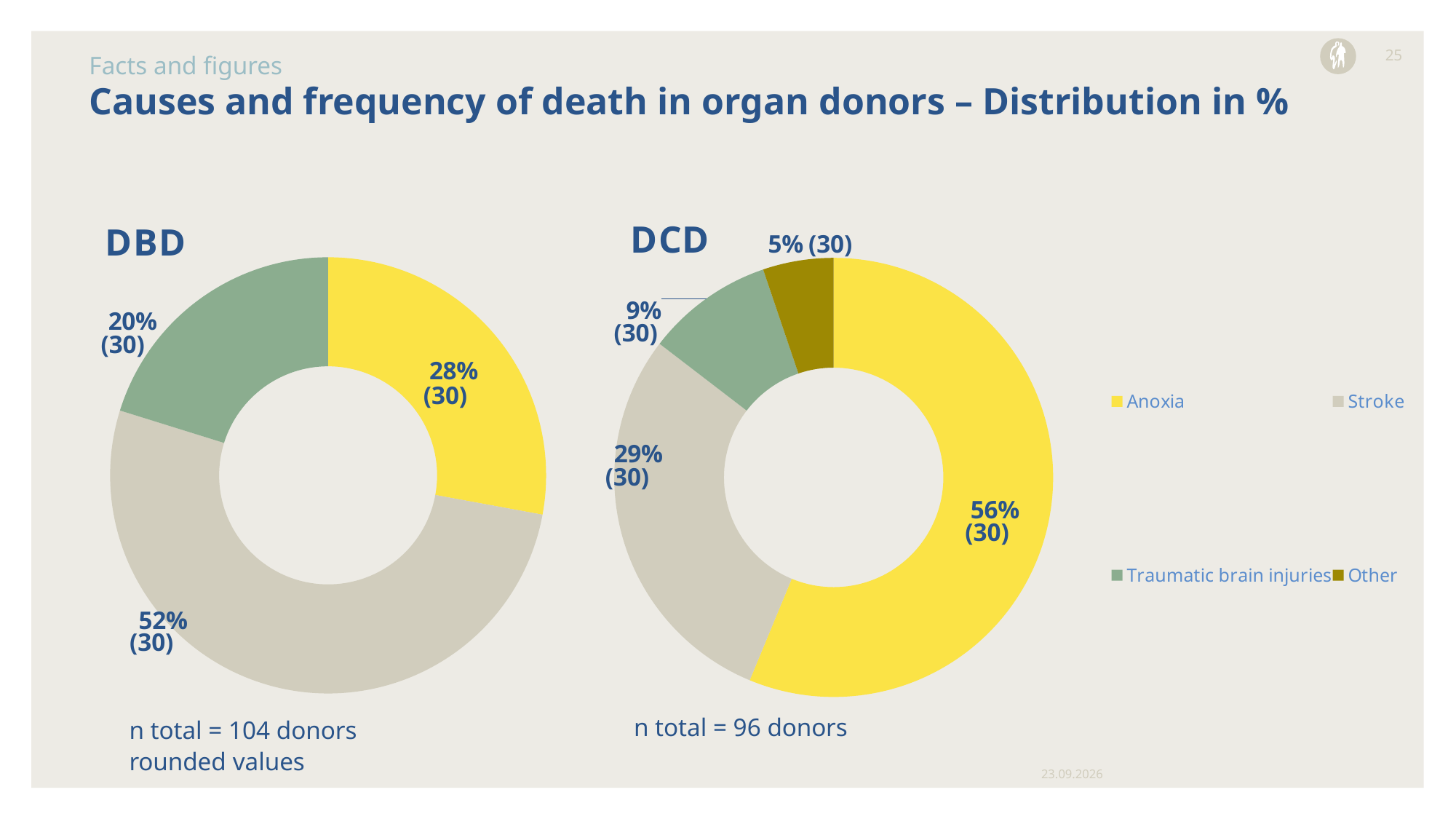
Is the share of Anoxia larger in the DBD chart or the DCD chart? DCD In the DCD chart, what percentage is shown for Other? 5% In the DCD chart, what is the difference in percentage points between Anoxia and Stroke? 27 In the DBD chart, what percentage is shown for Stroke? 52% In the DBD chart, which cause of death has the largest share? Stroke How many slices does the DCD chart have? 4 In the DBD chart, what percentage is shown for Traumatic brain injuries? 20% How many categories does the legend list? 4 What type of chart is used on this slide? Donut (pie) chart In the DCD chart, which cause of death has the smallest share? Other In the DCD chart, what percentage is shown for Anoxia? 56% How many slices does the DBD chart have? 3